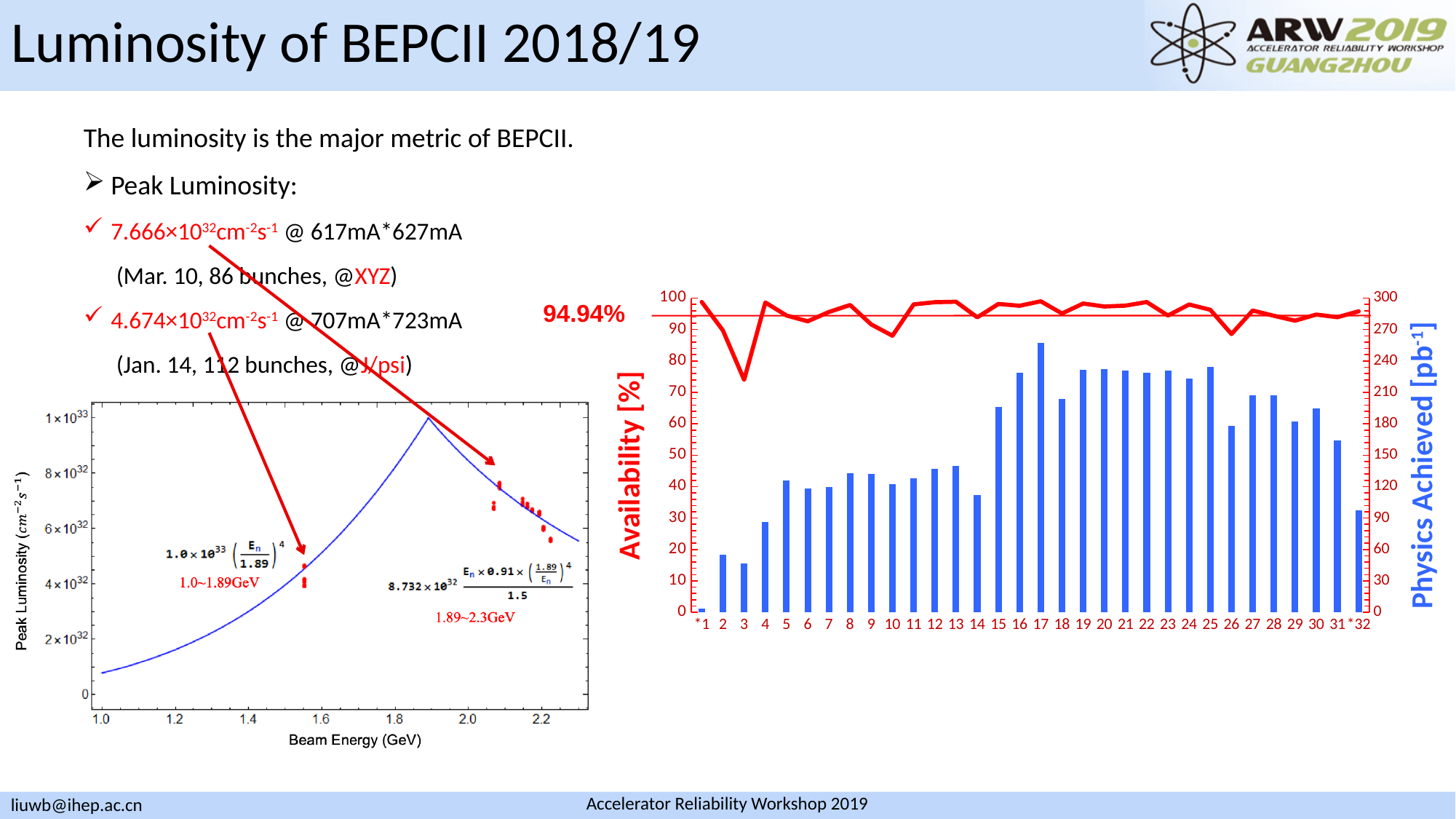
What is the x-axis label of the left chart? Beam Energy (GeV) On the right chart, which week has the highest Physics Achieved bar? 17 What is the label of the right-hand vertical axis of the right chart? Physics Achieved [pb-1] On the right chart, is the Physics Achieved value for week 17 greater or less than 240? greater On the right chart, which has the larger Physics Achieved bar, week 4 or week 5? week 5 How many weeks (categories) are shown on the x axis of the right chart? 32 On the right chart, is the Physics Achieved value for week 3 greater or less than 60? less What average availability value is labelled on the horizontal red line of the right chart? 94.94% On the right chart, which week has the lowest Availability on the red line? 3 On the right chart, which week has the lowest Physics Achieved bar? *1 On the right chart, is the Availability value for week 3 greater or less than 80? less